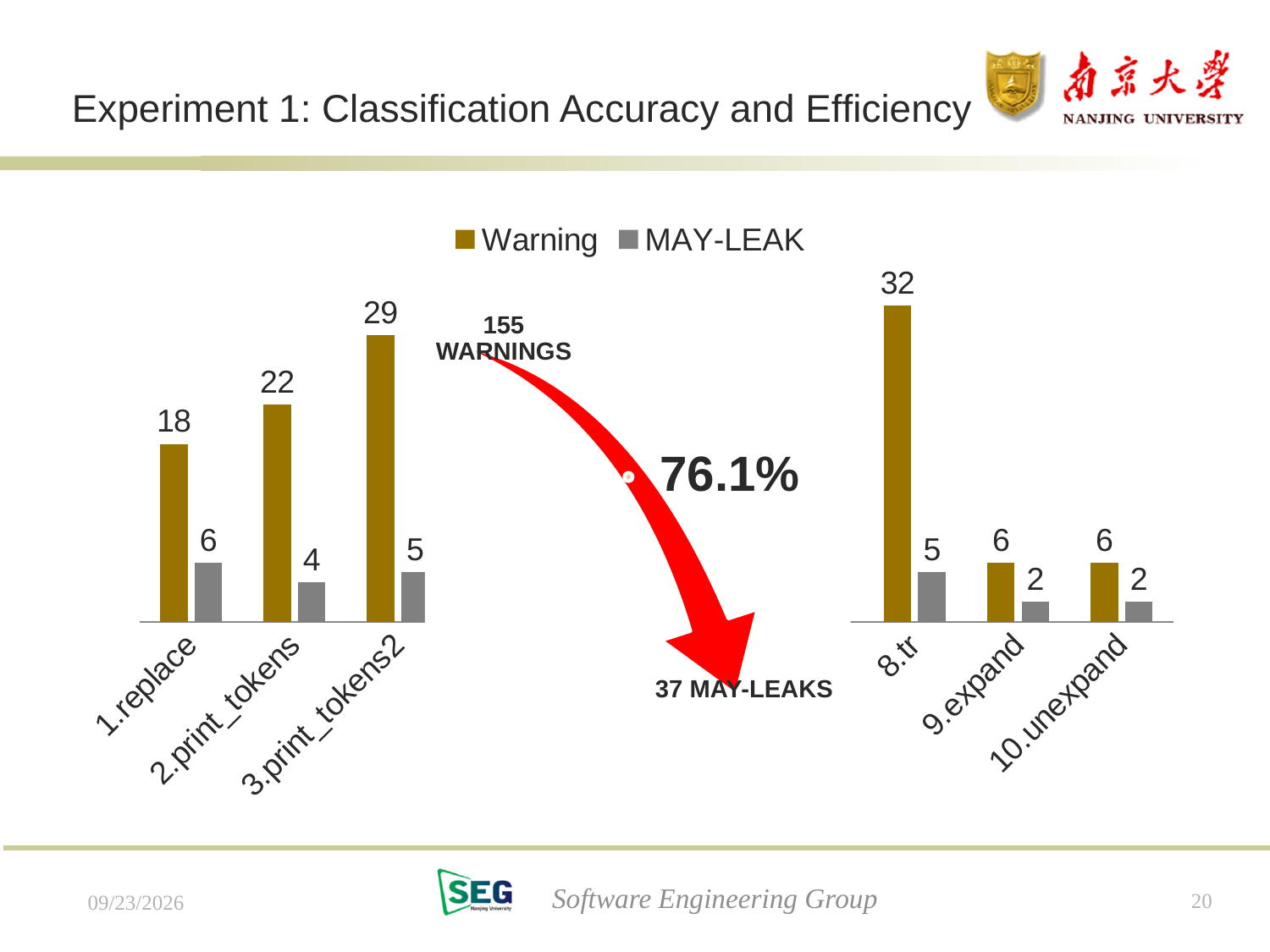
What are the two series named in the legend? Warning and MAY-LEAK Which visible category has the highest MAY-LEAK value? 1.replace What is the Warning value for 8.tr? 32 What is the MAY-LEAK value for 2.print_tokens? 4 What kind of chart is shown on the slide? Bar chart Which visible category has the highest Warning value? 8.tr How many series does the legend list? 2 What is the MAY-LEAK value for 10.unexpand? 2 What is the Warning value for 1.replace? 18 Which is larger, the Warning value for 2.print_tokens or the Warning value for 3.print_tokens2? 3.print_tokens2 What is the difference between the Warning values for 8.tr and 9.expand? 26 What is the difference between the Warning and MAY-LEAK values for 3.print_tokens2? 24